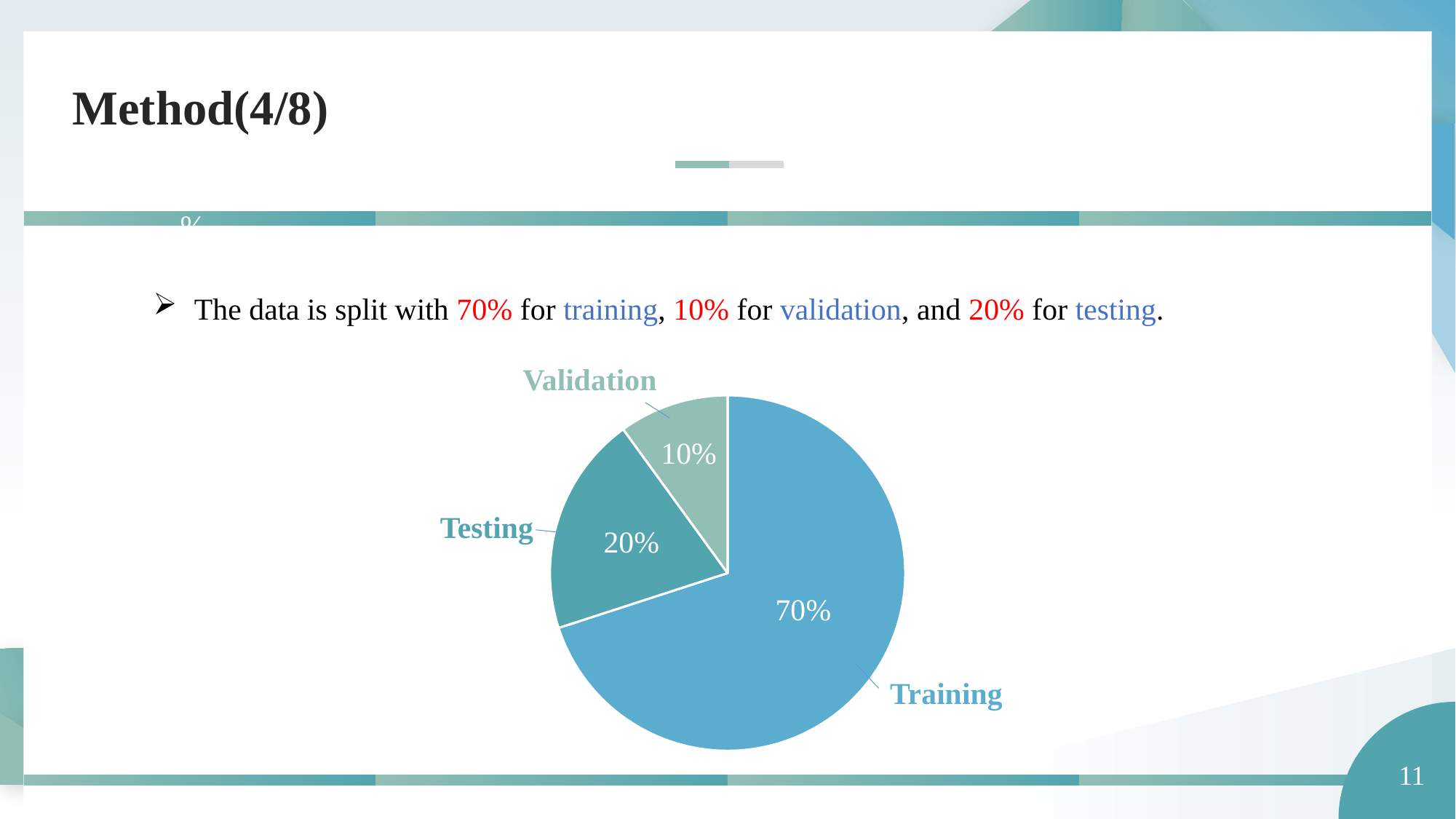
Is the Training share greater or less than 50%? greater Which slice of the pie is the smallest? Validation Which is larger, the Testing slice or the Validation slice? Testing Which slice of the pie is labelled with the value 20%? Testing How many slices does the pie chart have? 3 What share of the pie does Training take? 70% What share of the pie does Validation take? 10% What kind of chart is shown on the slide? pie chart What is the difference between the Testing share and the Validation share? 10% Which slice of the pie is the largest? Training What share of the pie does Testing take? 20% What is the difference between the Training share and the Testing share? 50%